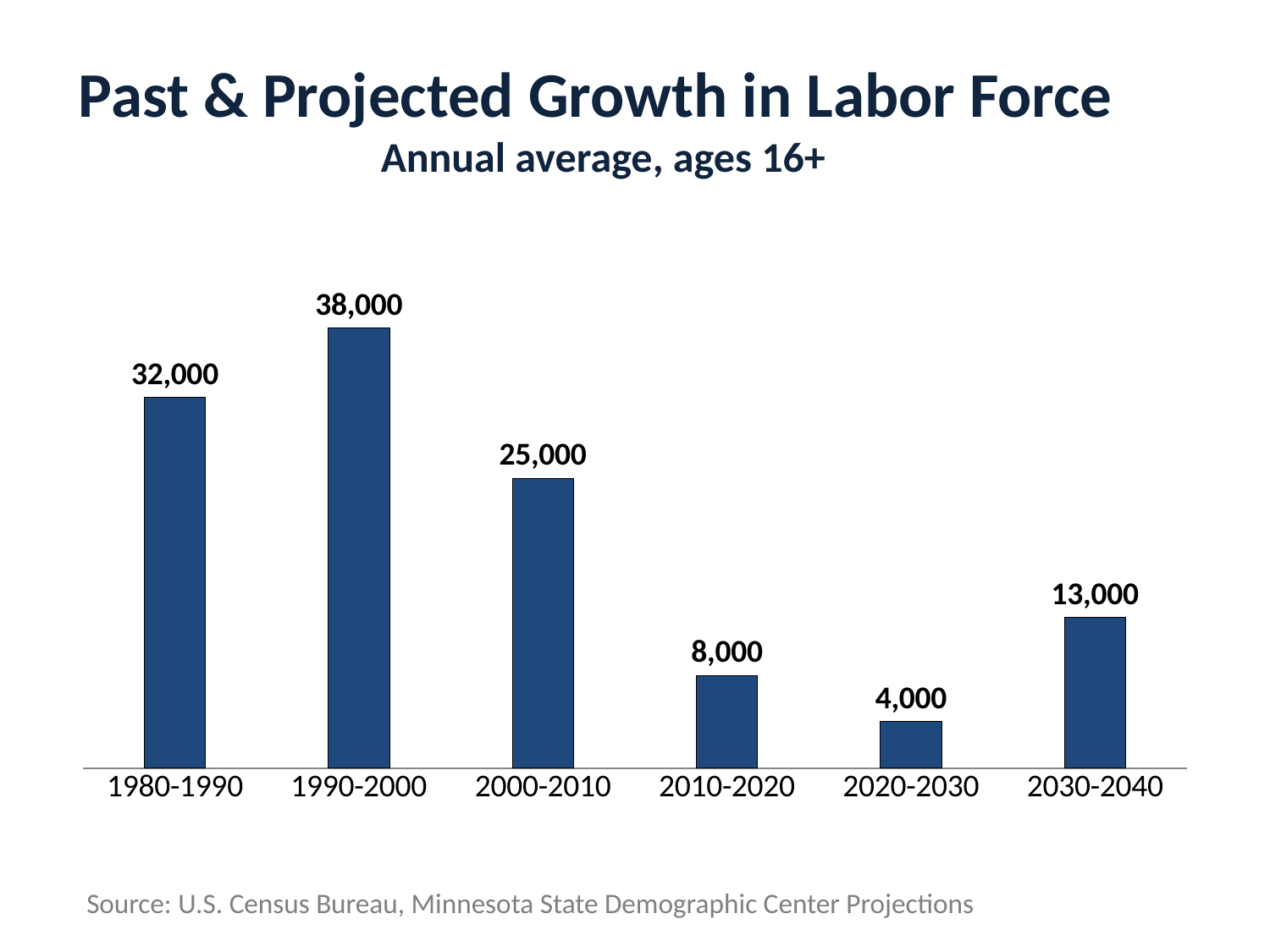
What is the annual average labor force growth for 1990-2000? 38,000 What kind of chart is shown on the slide? Bar chart What is the value shown for 2020-2030? 4,000 Which decade has the highest annual average labor force growth? 1990-2000 What is the difference between the values for 2010-2020 and 2030-2040? 5,000 Do the values rise or fall from 1990-2000 to 2020-2030? Fall What is the subtitle of the chart? Annual average, ages 16+ Which is larger, the value for 2010-2020 or the value for 2030-2040? 2030-2040 How many decades are shown on the x axis? 6 Which decade has the lowest annual average labor force growth? 2020-2030 What is the difference between the values for 1980-1990 and 2000-2010? 7,000 What is the value shown for 2030-2040? 13,000